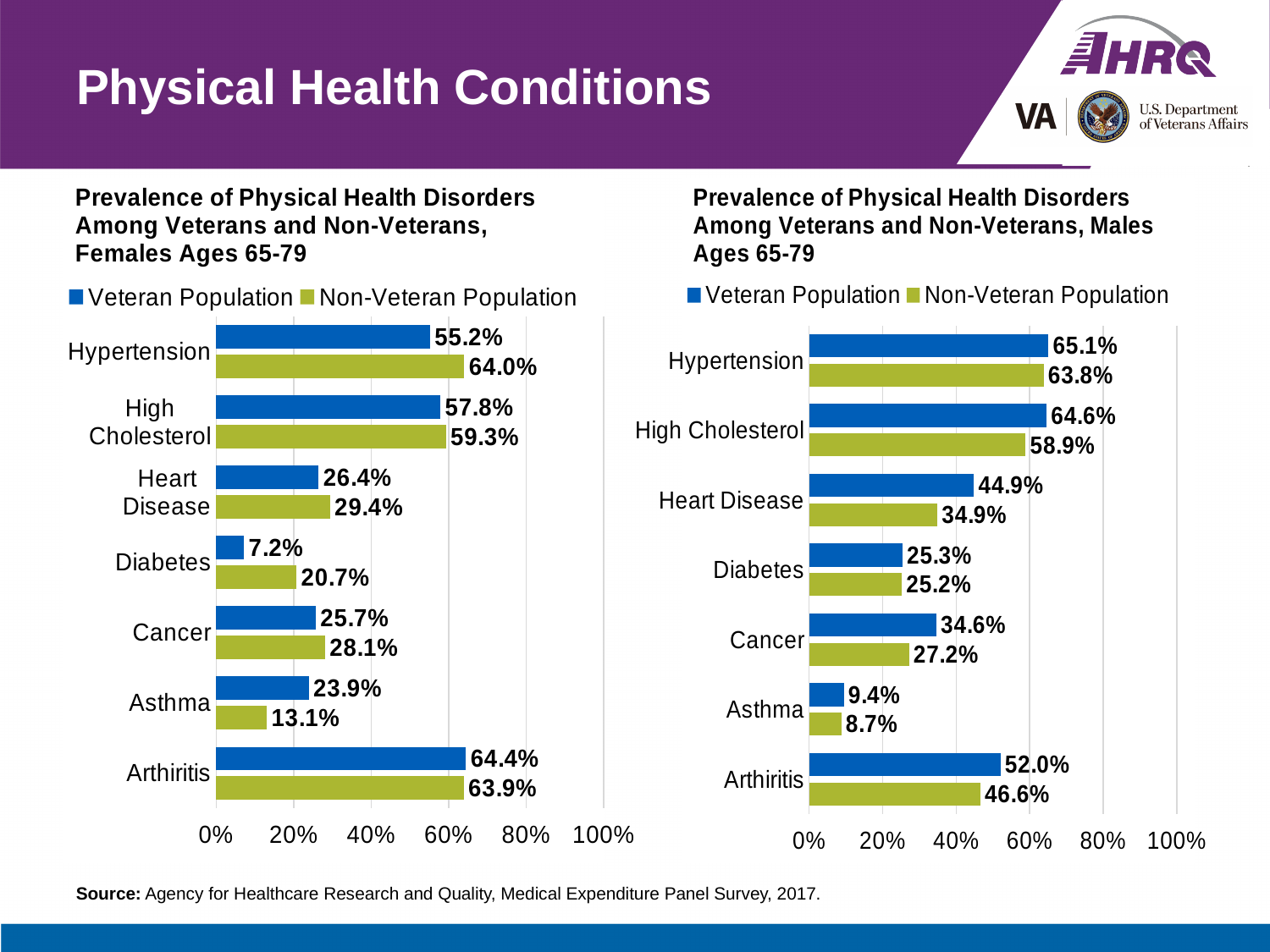
In the Females Ages 65-79 chart, which colour represents the Non-Veteran Population? Green How many series does the legend of the Females Ages 65-79 chart list? 2 In the Males Ages 65-79 chart, what is the Non-Veteran Population value for Heart Disease? 34.9% In the Females Ages 65-79 chart, is the Non-Veteran Population value for Hypertension greater or less than 60%? greater In the Males Ages 65-79 chart, which is larger for Heart Disease: the Veteran Population value or the Non-Veteran Population value? Veteran Population What type of chart is the Males Ages 65-79 chart? Bar chart In the Females Ages 65-79 chart, what is the difference between the Non-Veteran and Veteran Population values for Diabetes? 13.5% How many health conditions are listed in the Males Ages 65-79 chart? 7 In the Females Ages 65-79 chart, what is the Veteran Population value for Hypertension? 55.2% In the Males Ages 65-79 chart, what is the difference between the Veteran and Non-Veteran Population values for Arthiritis? 5.4% In the Females Ages 65-79 chart, which condition has the highest Veteran Population value? Arthiritis In the Males Ages 65-79 chart, which condition has the lowest Non-Veteran Population value? Asthma